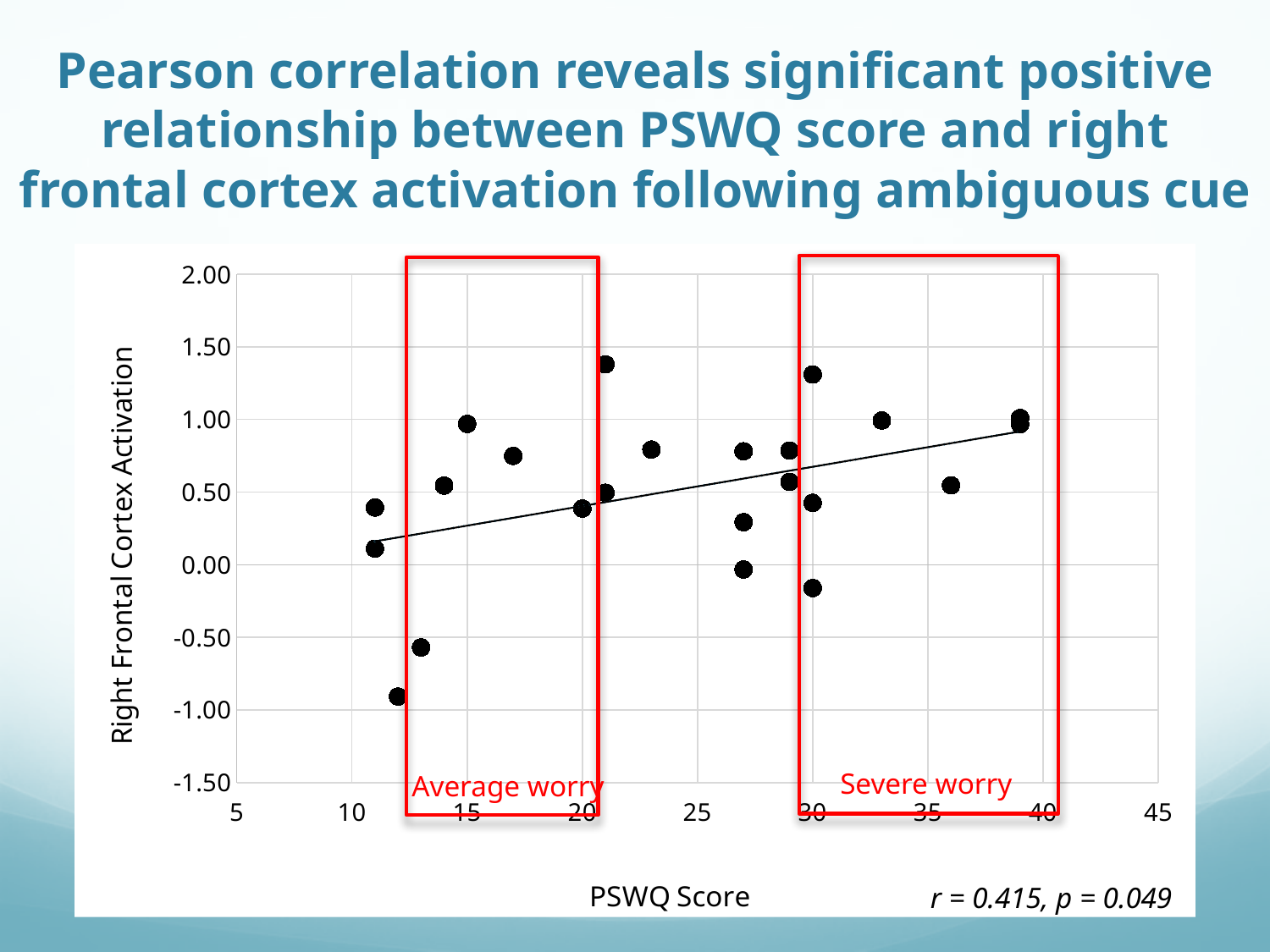
What correlation coefficient and p-value are reported on the chart? r = 0.415, p = 0.049 Is the trend line's value at a PSWQ score of 40 greater or less than 0.50? greater Is the highest plotted Right Frontal Cortex Activation value greater or less than 1.00? greater Is the trend line's value at a PSWQ score of 10 greater or less than 0.50? less What kind of chart is shown on the slide? Scatter plot What are the labels of the two red boxes drawn on the chart? Average worry and Severe worry Do the plotted values generally rise or fall as the PSWQ score increases along the x axis? Rise